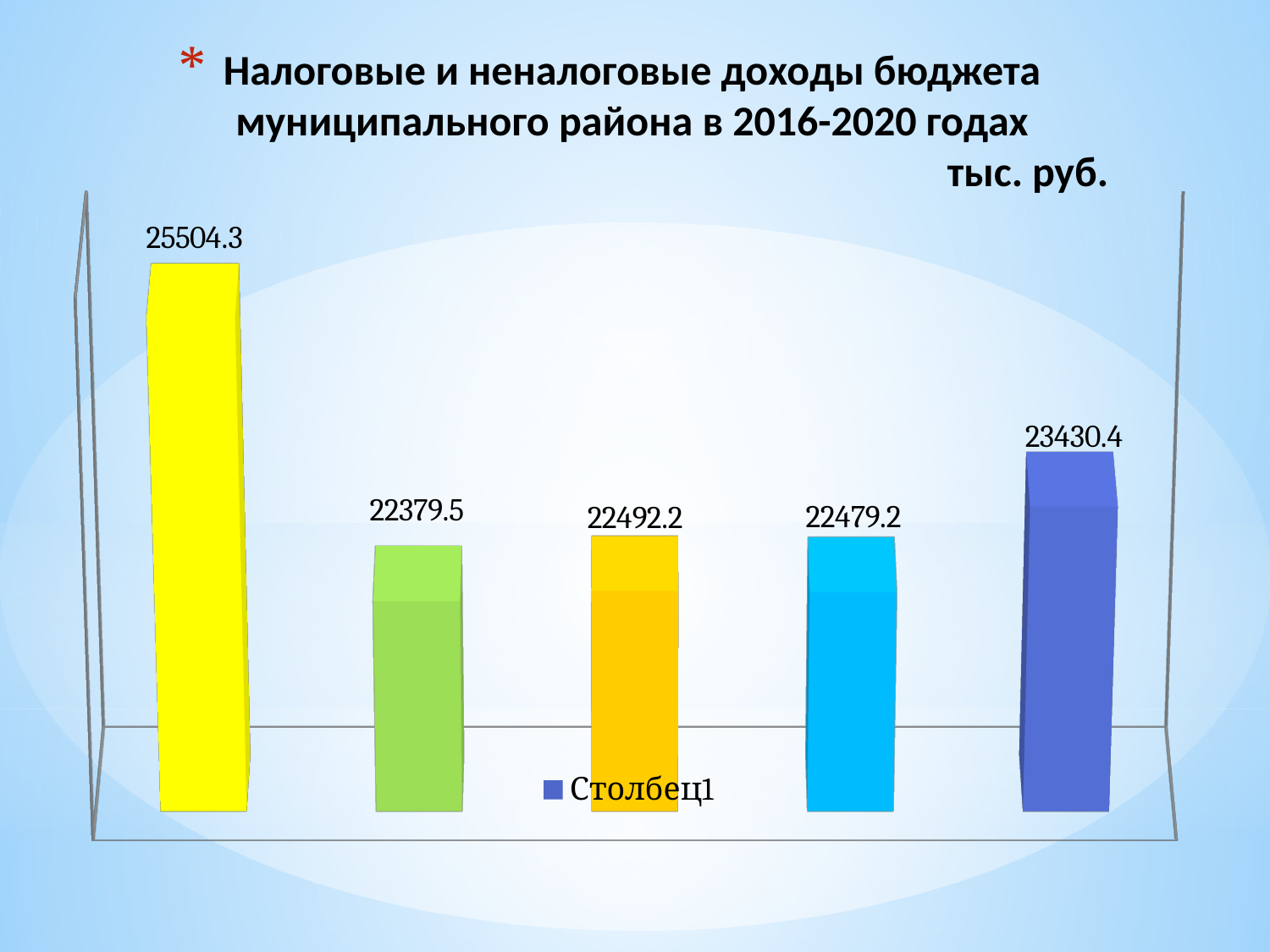
What is the value shown on the last (dark blue) bar on the right? 23430.4 Which bar has the highest value? The first (yellow) bar, 25504.3 Which is larger: the value of the orange bar or the value of the light blue bar? The orange bar (22492.2) How many bars are plotted on the chart? 5 What is the value shown on the orange bar in the middle? 22492.2 Which bar has the lowest value? The second (green) bar, 22379.5 What is the difference between the value of the first (yellow) bar and the last (dark blue) bar? 2073.9 What type of chart is shown on the slide? Bar chart What is the value shown on the light blue bar? 22479.2 What entry does the chart legend list? Столбец1 What is the value shown on the first (yellow) bar from the left? 25504.3 What is the value shown on the green bar? 22379.5